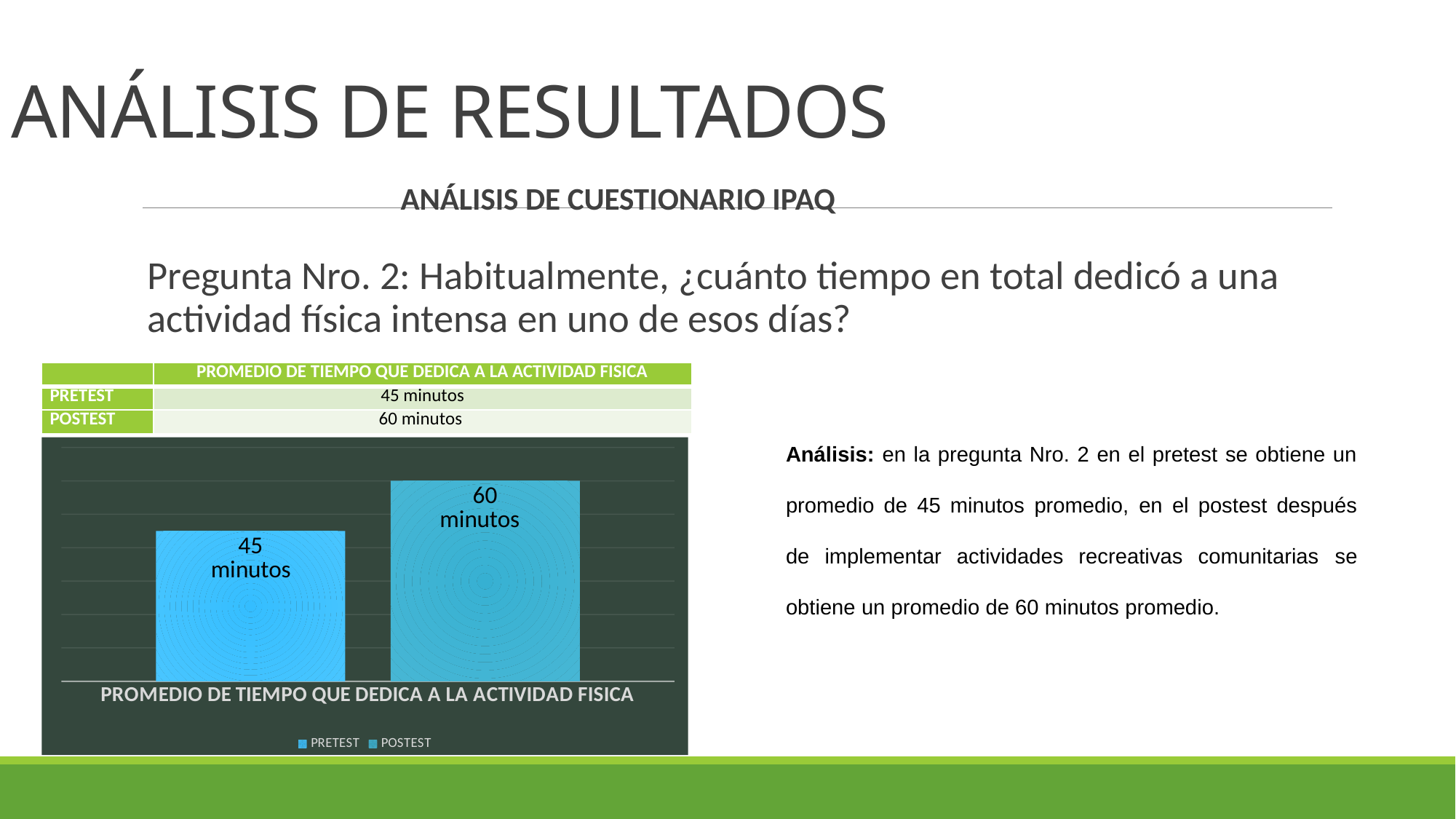
Which is larger, the PRETEST value or the POSTEST value? POSTEST Which series has the highest value in the chart? POSTEST What kind of chart is shown on the slide? Bar chart What is the difference in minutes between the POSTEST and PRETEST values? 15 minutos Which series has the lowest value in the chart? PRETEST What are the two legend entries in the chart? PRETEST and POSTEST What is the value for PRETEST in the chart? 45 minutos How many bars are plotted in the chart? 2 How many series does the legend list? 2 What is the value for POSTEST in the chart? 60 minutos What is the category label shown under the bars in the chart? PROMEDIO DE TIEMPO QUE DEDICA A LA ACTIVIDAD FISICA